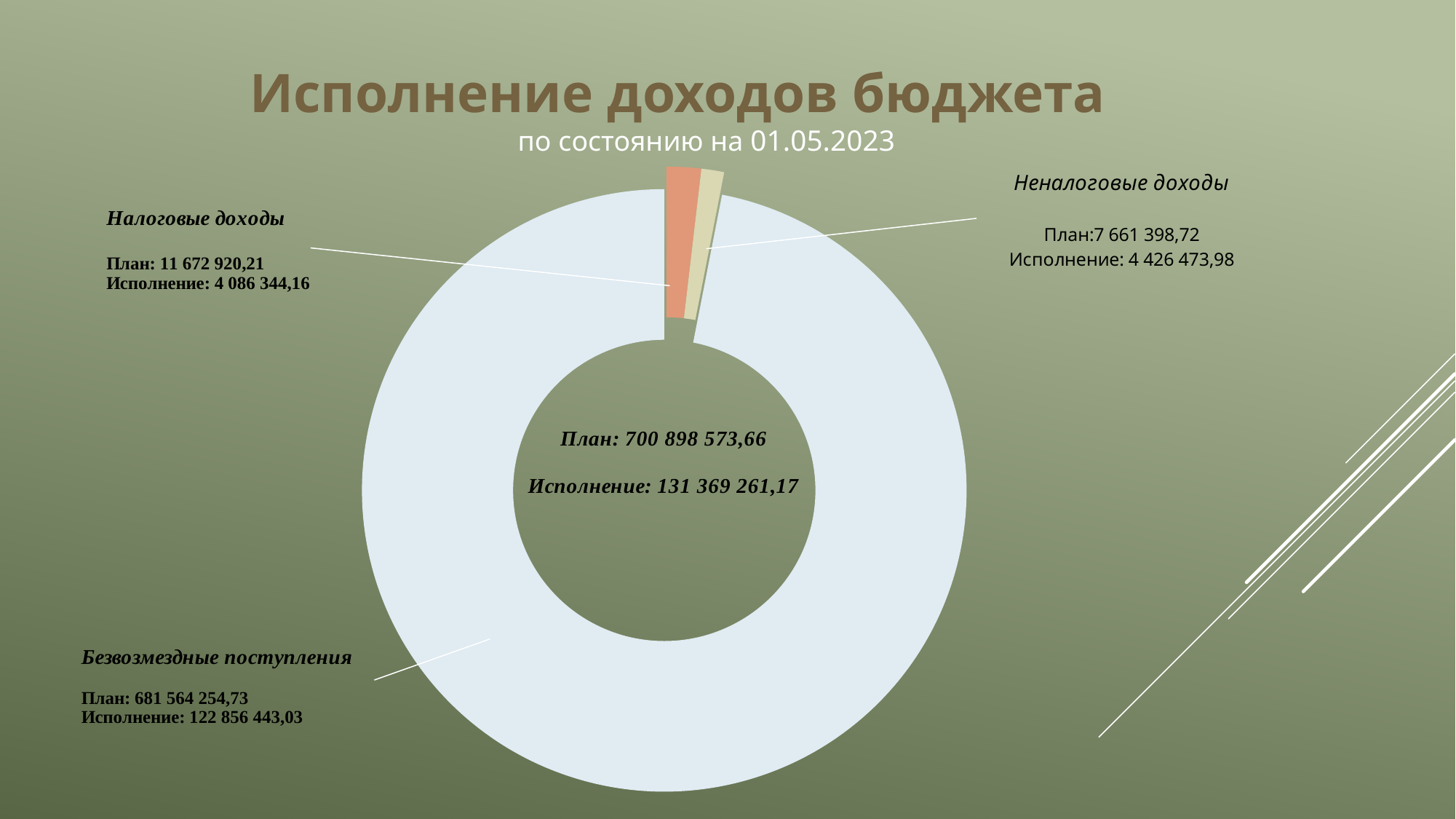
How many revenue categories are shown in the doughnut chart? 3 What is the difference between the planned value and the executed value for Неналоговые доходы? 3 234 924,74 What is the total planned value (План) shown in the centre of the doughnut? 700 898 573,66 Which category occupies the largest segment of the doughnut? Безвозмездные поступления What kind of chart is shown on the slide? Doughnut chart What is the total executed value (Исполнение) shown in the centre of the doughnut? 131 369 261,17 What is the planned value (План) for Безвозмездные поступления? 681 564 254,73 What is the planned value (План) for Налоговые доходы? 11 672 920,21 Which has the larger planned value: Налоговые доходы or Неналоговые доходы? Налоговые доходы What is the executed value (Исполнение) for Неналоговые доходы? 4 426 473,98 Which category has the smallest planned value (План)? Неналоговые доходы What is the difference between the planned values of Налоговые доходы and Неналоговые доходы? 4 011 521,49